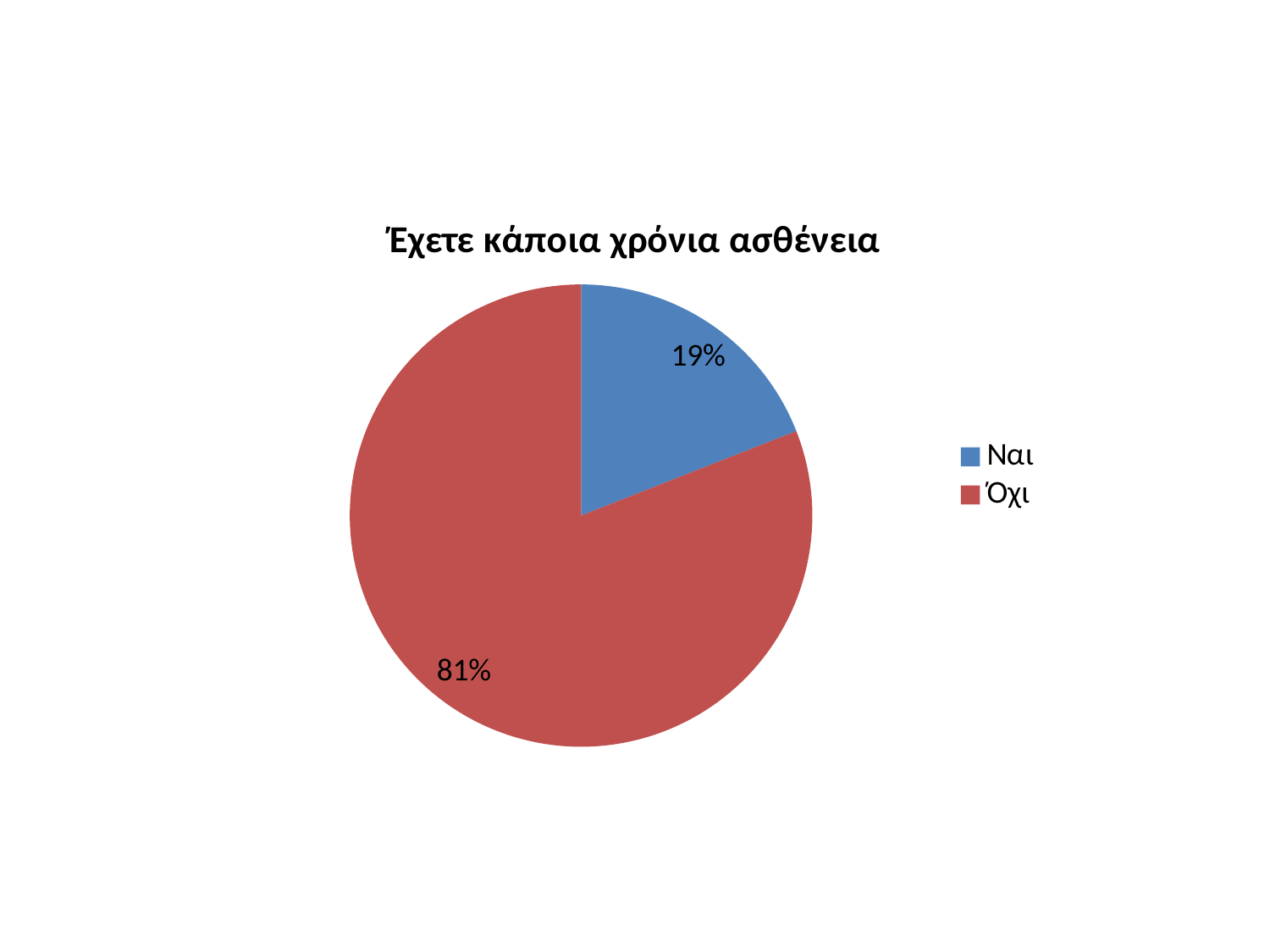
How many entries does the legend list? 2 Which category has the smallest share of the pie? Ναι What share of the pie does the Όχι slice represent? 81% What kind of chart is shown on the slide? pie chart What percentage of the pie is labelled Ναι? 19% Which category has the largest share of the pie? Όχι How many slices does the pie chart have? 2 What is the difference in percentage points between the Όχι and Ναι slices? 62 What is the title of the chart? Έχετε κάποια χρόνια ασθένεια Which slice is larger, Ναι or Όχι? Όχι What colour is the Ναι slice? blue What percentage of the pie is labelled Όχι? 81%